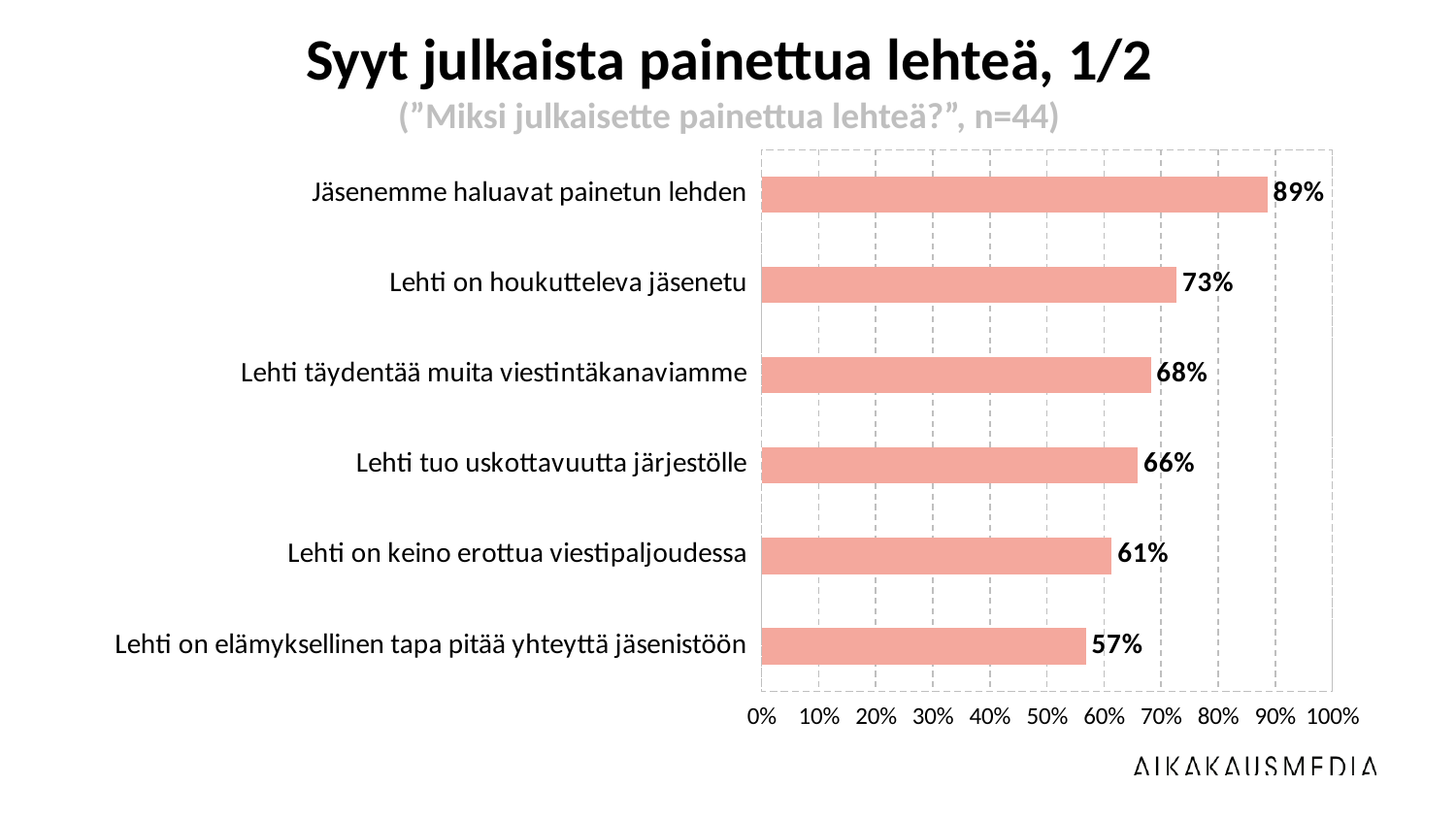
What is the difference between the values for "Lehti on keino erottua viestipaljoudessa" and "Lehti on elämyksellinen tapa pitää yhteyttä jäsenistöön"? 4% How many categories are shown in the chart? 6 What is the sample size (n) stated in the chart subtitle? n=44 Which is larger: the value for "Lehti täydentää muita viestintäkanaviamme" or for "Lehti on keino erottua viestipaljoudessa"? Lehti täydentää muita viestintäkanaviamme Is the value for "Lehti on houkutteleva jäsenetu" greater or less than 70%? greater What is the value for "Lehti tuo uskottavuutta järjestölle"? 66% What is the value for "Lehti on elämyksellinen tapa pitää yhteyttä jäsenistöön"? 57% What is the difference between the values for "Jäsenemme haluavat painetun lehden" and "Lehti on houkutteleva jäsenetu"? 16% Which category has the lowest value? Lehti on elämyksellinen tapa pitää yhteyttä jäsenistöön Which category has the highest value? Jäsenemme haluavat painetun lehden What is the value for "Jäsenemme haluavat painetun lehden"? 89% What kind of chart is shown on the slide? bar chart